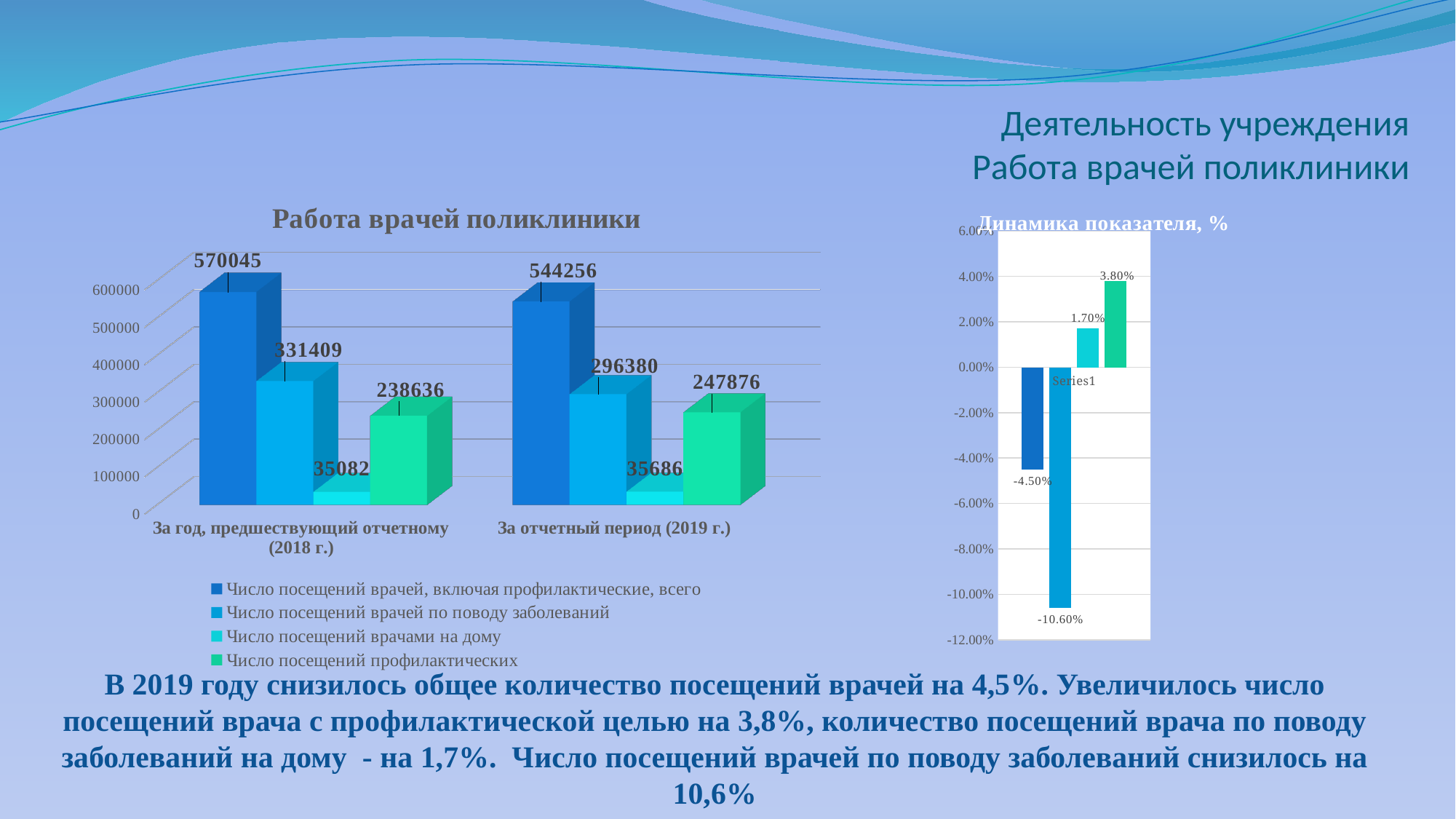
In the chart 'Динамика показателя, %', what is the highest value shown? 3.80% In the chart 'Работа врачей поликлиники', what is the value of 'Число посещений профилактических' for 'За отчетный период (2019 г.)'? 247876 In the chart 'Работа врачей поликлиники', which series has the lowest value for 'За год, предшествующий отчетному (2018 г.)'? Число посещений врачами на дому How many bars are plotted in the chart 'Динамика показателя, %'? 4 In the chart 'Работа врачей поликлиники', what is the value of 'Число посещений врачей, включая профилактические, всего' for 'За отчетный период (2019 г.)'? 544256 In the chart 'Работа врачей поликлиники', what is the difference between 'Число посещений врачей по поводу заболеваний' in 2018 and in 2019? 35029 What kind of chart is 'Динамика показателя, %'? bar chart In the chart 'Динамика показателя, %', what is the lowest value shown? -10.60% In the chart 'Работа врачей поликлиники', what is the value of 'Число посещений врачами на дому' for 'За год, предшествующий отчетному (2018 г.)'? 35082 In the chart 'Работа врачей поликлиники', which is larger: 'Число посещений профилактических' in 2018 or in 2019? 2019 How many categories are shown on the x axis of the chart 'Работа врачей поликлиники'? 2 How many series does the legend of the chart 'Работа врачей поликлиники' list? 4